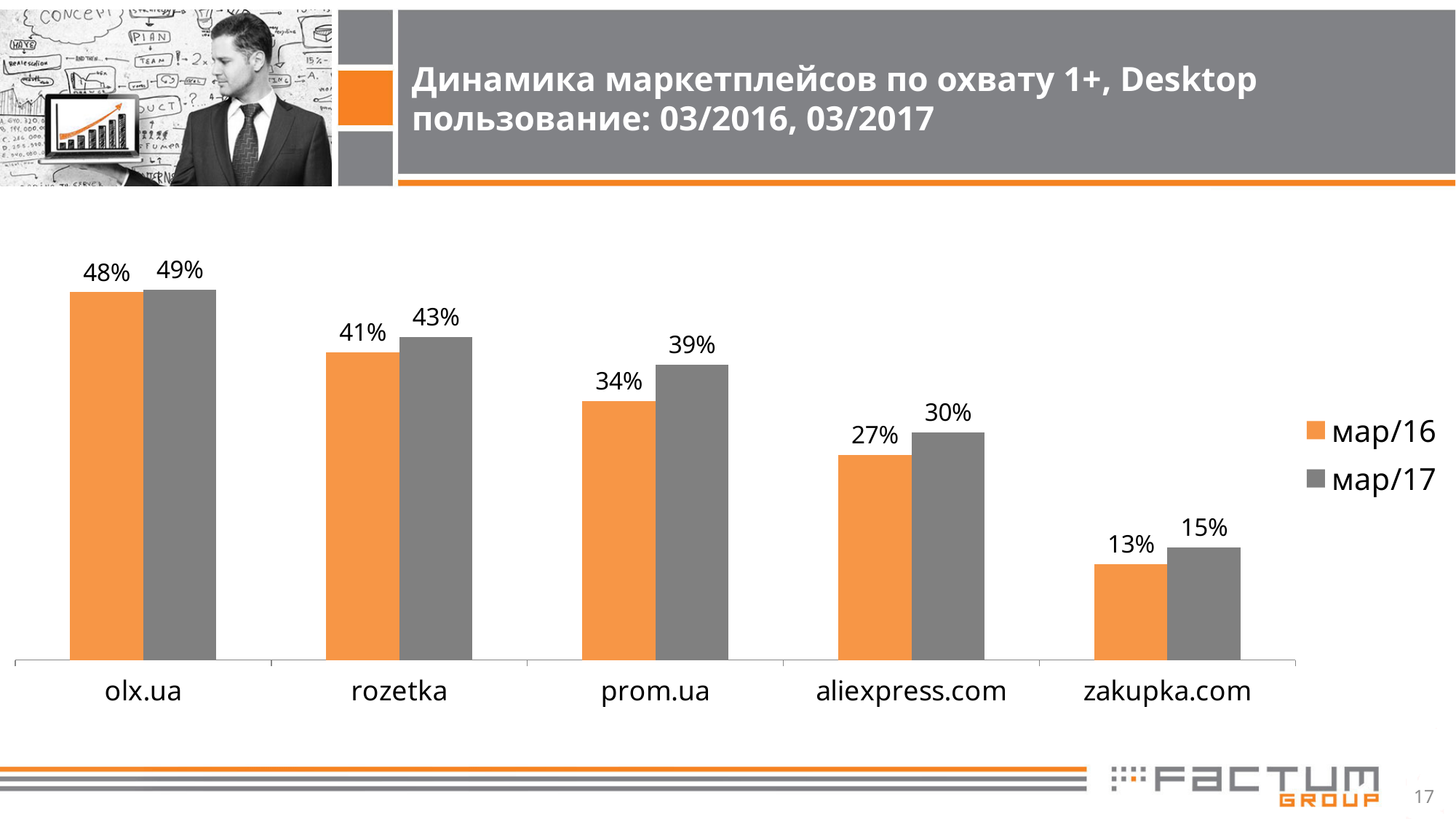
Which category has the highest value in the мар/17 series? olx.ua What is the difference between the мар/16 values for olx.ua and rozetka? 7% Which colour represents the мар/16 series? orange What is the value for rozetka in the мар/17 series? 43% How many categories are shown on the x axis? 5 How many series does the legend list? 2 Which is larger: the мар/17 value for prom.ua or the мар/16 value for rozetka? мар/16 value for rozetka Which category has the lowest value in the мар/16 series? zakupka.com What kind of chart is shown on the slide? bar chart What is the difference between the мар/17 and мар/16 values for prom.ua? 5% What is the value for aliexpress.com in the мар/16 series? 27% What is the value for zakupka.com in the мар/17 series? 15%